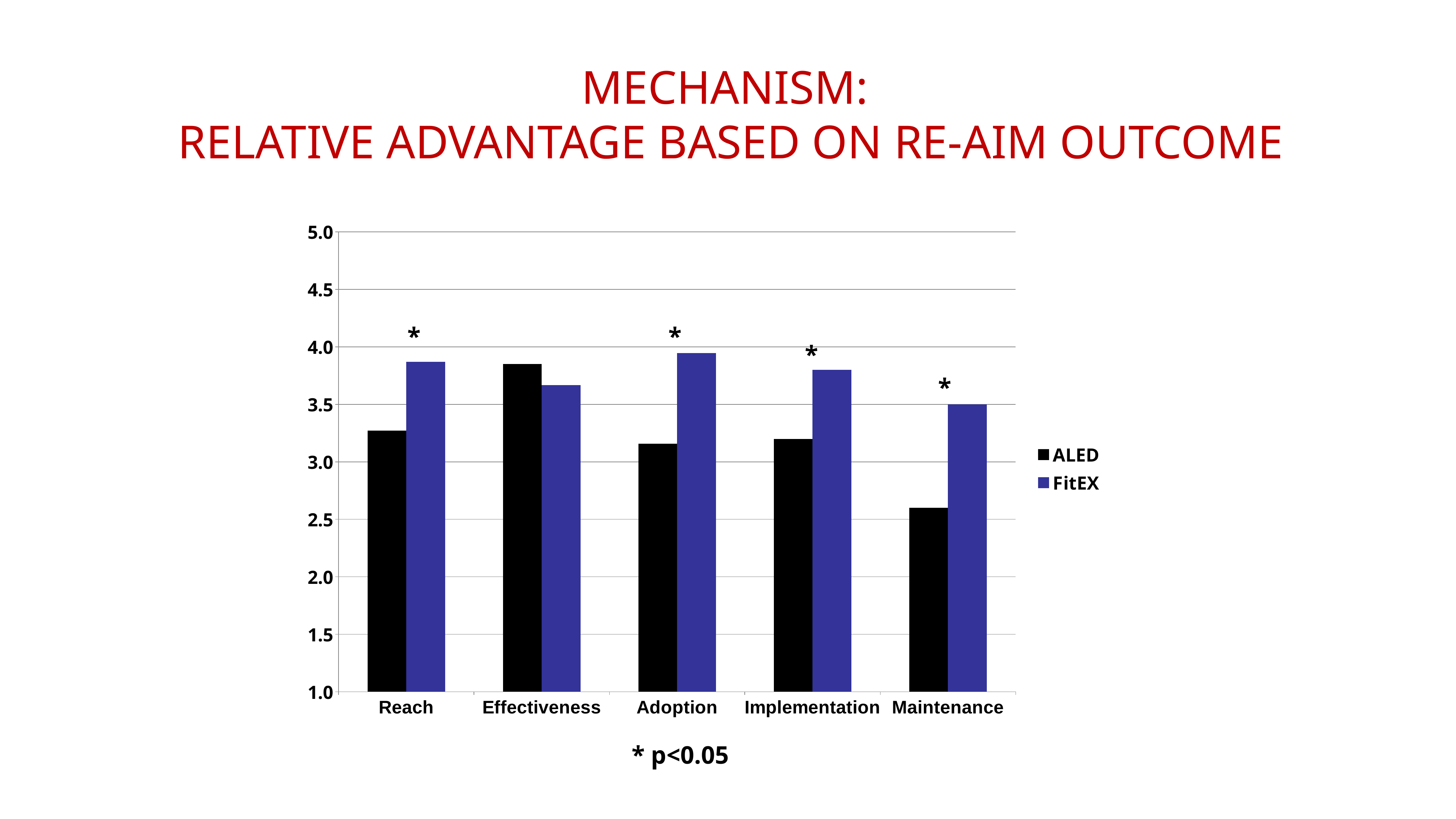
How many categories are shown on the x axis of the chart? 5 Is the ALED value for Maintenance greater or less than 3.0? less Is the FitEX value for Reach greater or less than 3.5? greater How many series does the chart's legend list? 2 What kind of chart is shown on the slide? bar chart For Reach, which series has the larger value, ALED or FitEX? FitEX Which category has the lowest ALED value? Maintenance For Effectiveness, which series has the larger value, ALED or FitEX? ALED Is the ALED value for Adoption greater or less than 3.5? less Which category has the lowest FitEX value? Maintenance Which colour represents the FitEX series in the chart? blue Which category has the highest ALED value? Effectiveness